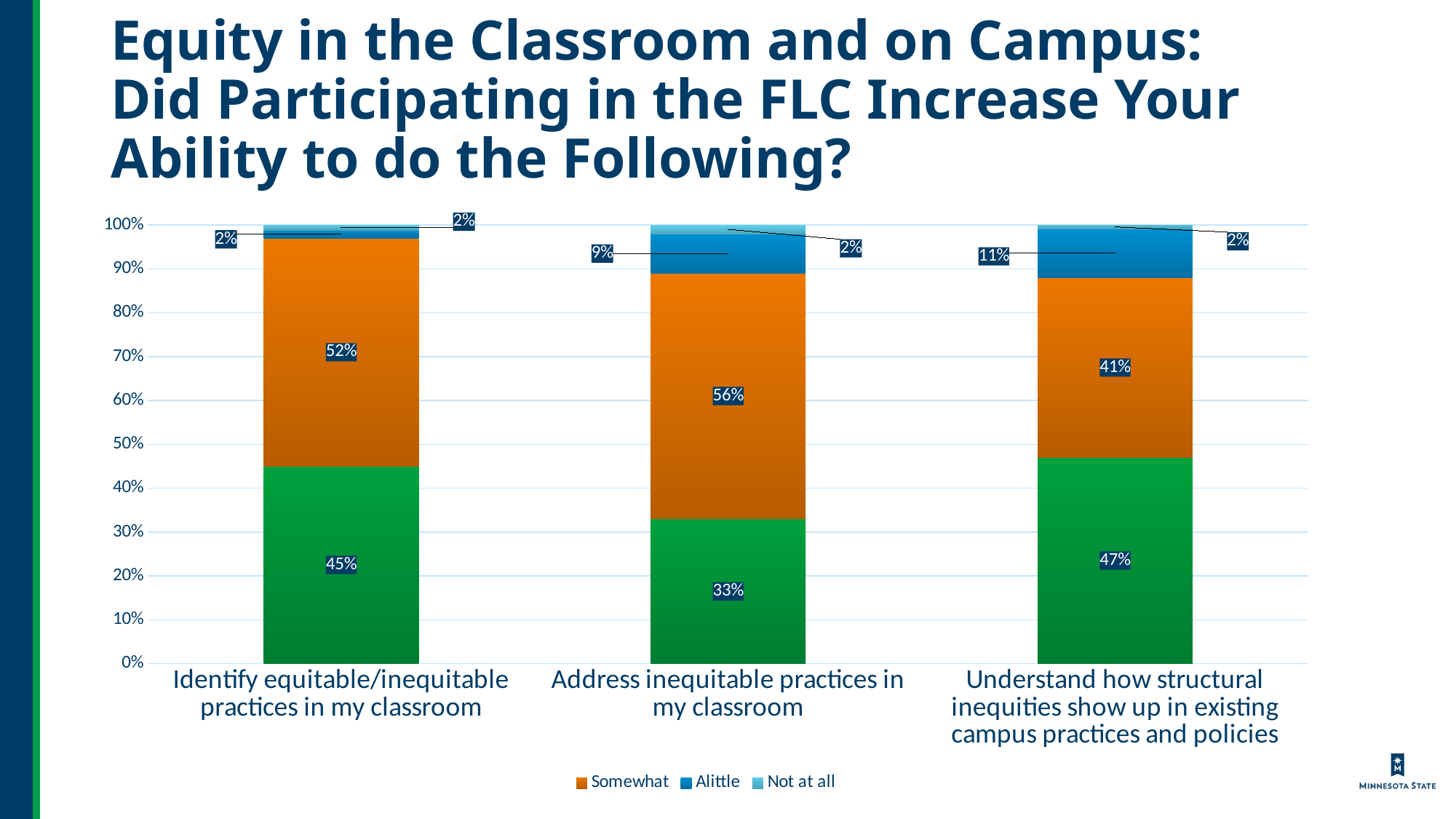
What percentage of respondents answered "Not at all" for "Address inequitable practices in my classroom"? 2% What value is printed on the green segment of the bar for "Identify equitable/inequitable practices in my classroom"? 45% How many series does the chart's legend list? 3 How many categories are shown on the x axis of the chart? 3 Which has a larger "Alittle" percentage: "Address inequitable practices in my classroom" or "Understand how structural inequities show up in existing campus practices and policies"? Understand how structural inequities show up in existing campus practices and policies What percentage of respondents answered "Alittle" for "Understand how structural inequities show up in existing campus practices and policies"? 11% What percentage of respondents answered "Somewhat" for "Identify equitable/inequitable practices in my classroom"? 52% Which category has the highest "Somewhat" percentage? Address inequitable practices in my classroom What percentage of respondents answered "Somewhat" for "Address inequitable practices in my classroom"? 56% What is the difference in the "Somewhat" percentage between "Address inequitable practices in my classroom" and "Understand how structural inequities show up in existing campus practices and policies"? 15 percentage points What kind of chart is shown on the slide? Stacked bar chart Which category has the lowest "Somewhat" percentage? Understand how structural inequities show up in existing campus practices and policies